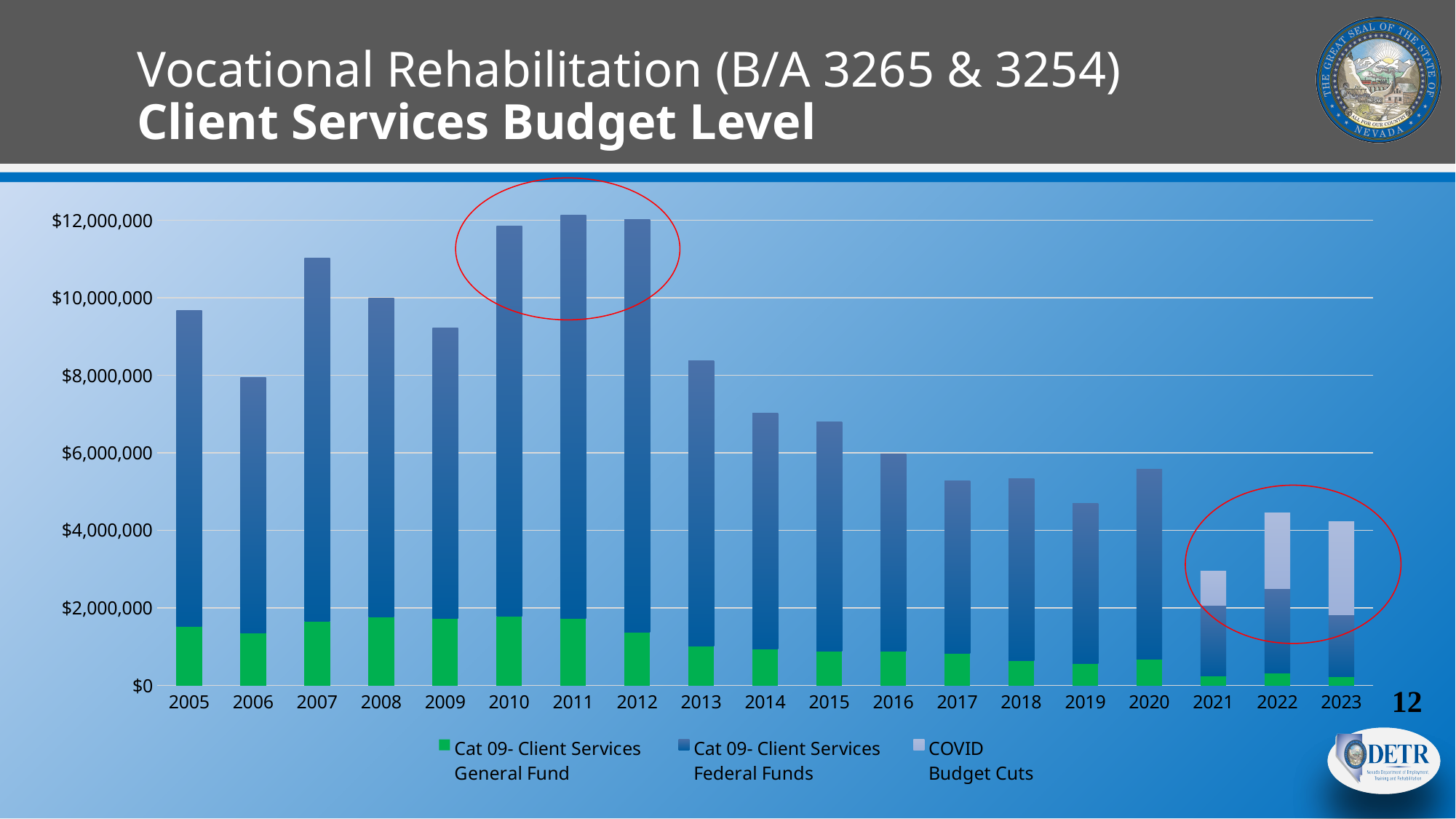
Is the total bar for 2013 greater or less than $8,000,000? greater Do the total bar heights generally rise or fall from 2012 to 2021? fall Which year has the tallest total bar in the chart? 2011 Is the total bar for 2005 greater or less than $8,000,000? greater Which year has the taller total bar, 2007 or 2008? 2007 Which series is shown in green in the chart's legend? Cat 09- Client Services General Fund How many years are shown along the x axis of the chart? 19 Which year has the shortest total bar in the chart? 2021 Which years include the COVID Budget Cuts series in their bars? 2021, 2022 and 2023 Is the total bar for 2019 greater or less than $6,000,000? less How many series does the chart's legend list? 3 What kind of chart is shown on the slide? Stacked bar chart